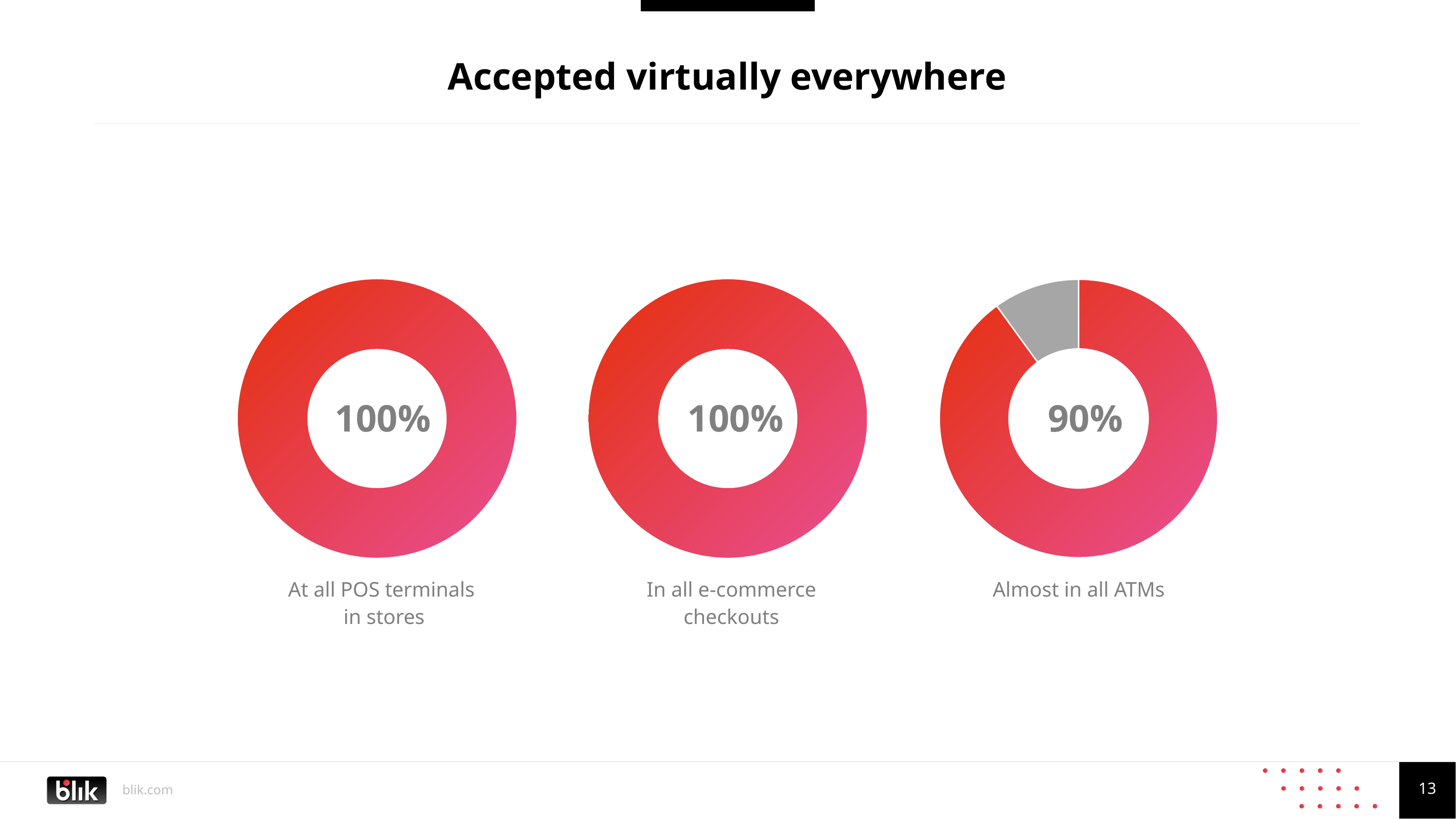
How many donut charts are shown on the slide? 3 In the right donut chart labelled 'Almost in all ATMs', what share of the ring is grey? 10% Is the percentage for POS terminals in stores larger than the percentage for ATMs? Yes Which donut chart contains a grey segment? Almost in all ATMs What percentage is shown in the centre of the right donut chart labelled 'Almost in all ATMs'? 90% Which of the three donut charts shows the lowest percentage? Almost in all ATMs What percentage is shown in the centre of the left donut chart labelled 'At all POS terminals in stores'? 100% What is the title of the slide? Accepted virtually everywhere What percentage is shown in the centre of the middle donut chart labelled 'In all e-commerce checkouts'? 100% What kind of chart is used to show the percentages on this slide? Donut chart What is the difference between the percentage for POS terminals in stores and the percentage for ATMs? 10%